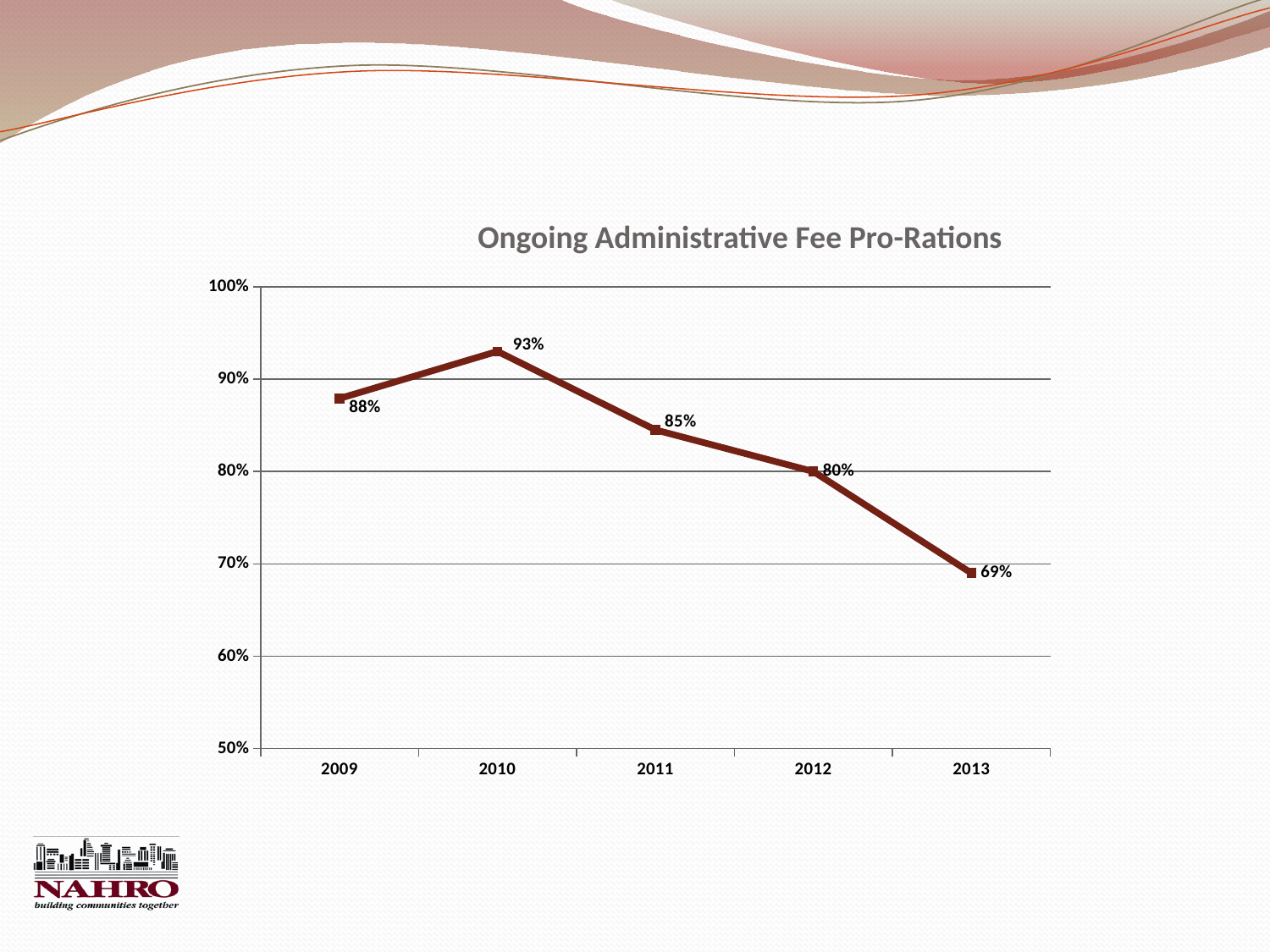
What is the difference between the 2010 value and the 2013 value? 24% Is the value for 2012 greater or less than 90%? less Which year has the highest pro-ration value? 2010 What is the value shown for 2009? 88% What is the title of the chart? Ongoing Administrative Fee Pro-Rations What is the ongoing administrative fee pro-ration for 2010? 93% Which year has a larger value, 2009 or 2011? 2009 How many years are plotted on the chart? 5 Which year has the lowest pro-ration value? 2013 What is the difference between the 2011 value and the 2012 value? 5% What kind of chart is shown on the slide? line chart What is the ongoing administrative fee pro-ration for 2013? 69%